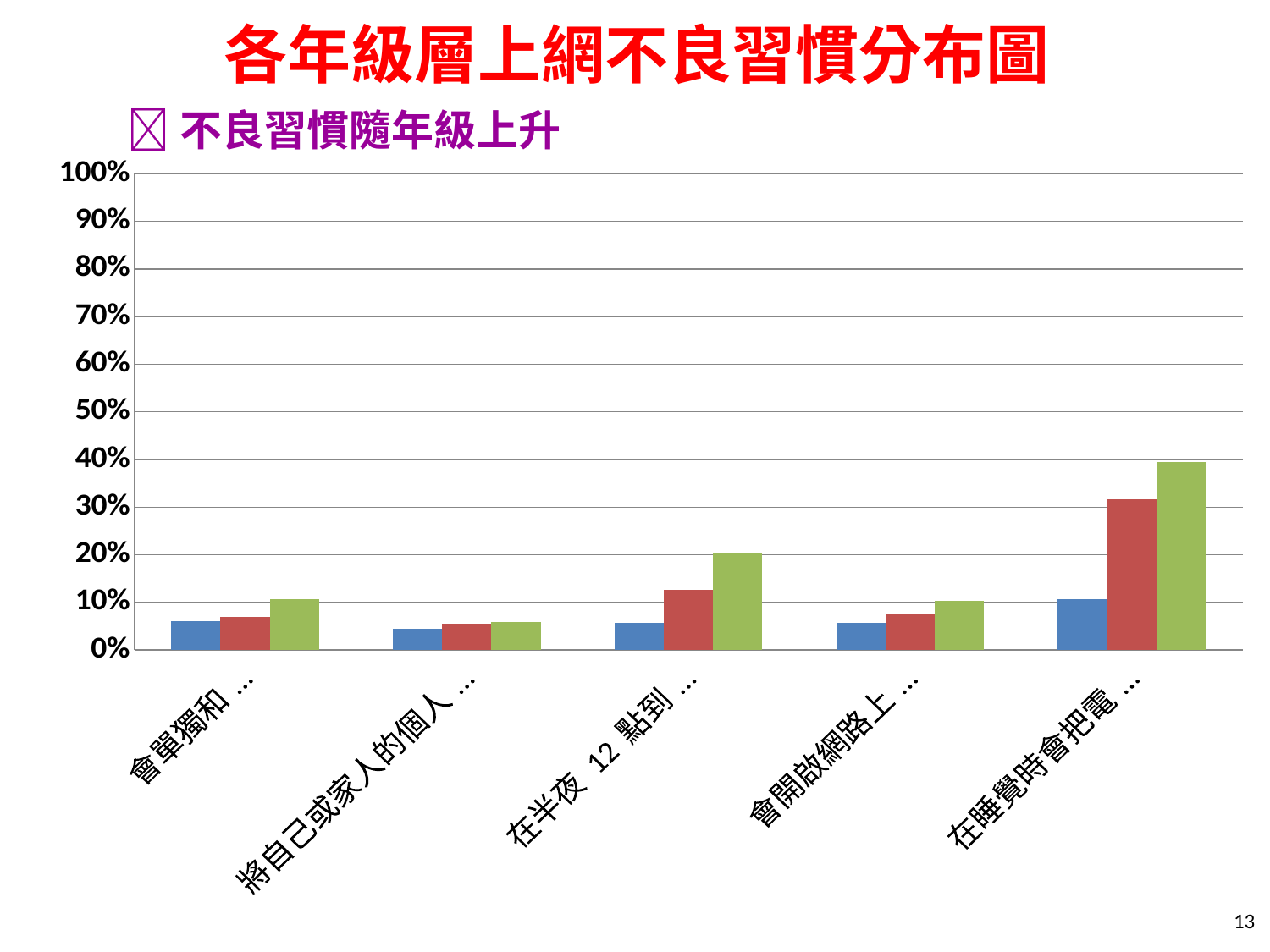
What kind of chart is shown on the slide? bar chart Is the green bar for the category "在睡覺時會把電…" greater or less than 30%? greater How many categories are shown along the x axis of the chart? 5 Within the category "在睡覺時會把電…", do the bars rise or fall from left (blue) to right (green)? rise How many differently coloured bars are shown for each category in the chart? 3 Which category has the tallest green bar? 在睡覺時會把電… Is the green bar for the category "在半夜 12 點到…" greater or less than 10%? greater Is the blue bar for the category "會單獨和…" greater or less than 10%? less What is the title of the chart on the slide? 各年級層上網不良習慣分布圖 Which is larger: the green bar for "在半夜 12 點到…" or the green bar for "會開啟網路上…"? 在半夜 12 點到… Which category has the lowest green bar? 將自己或家人的個人…